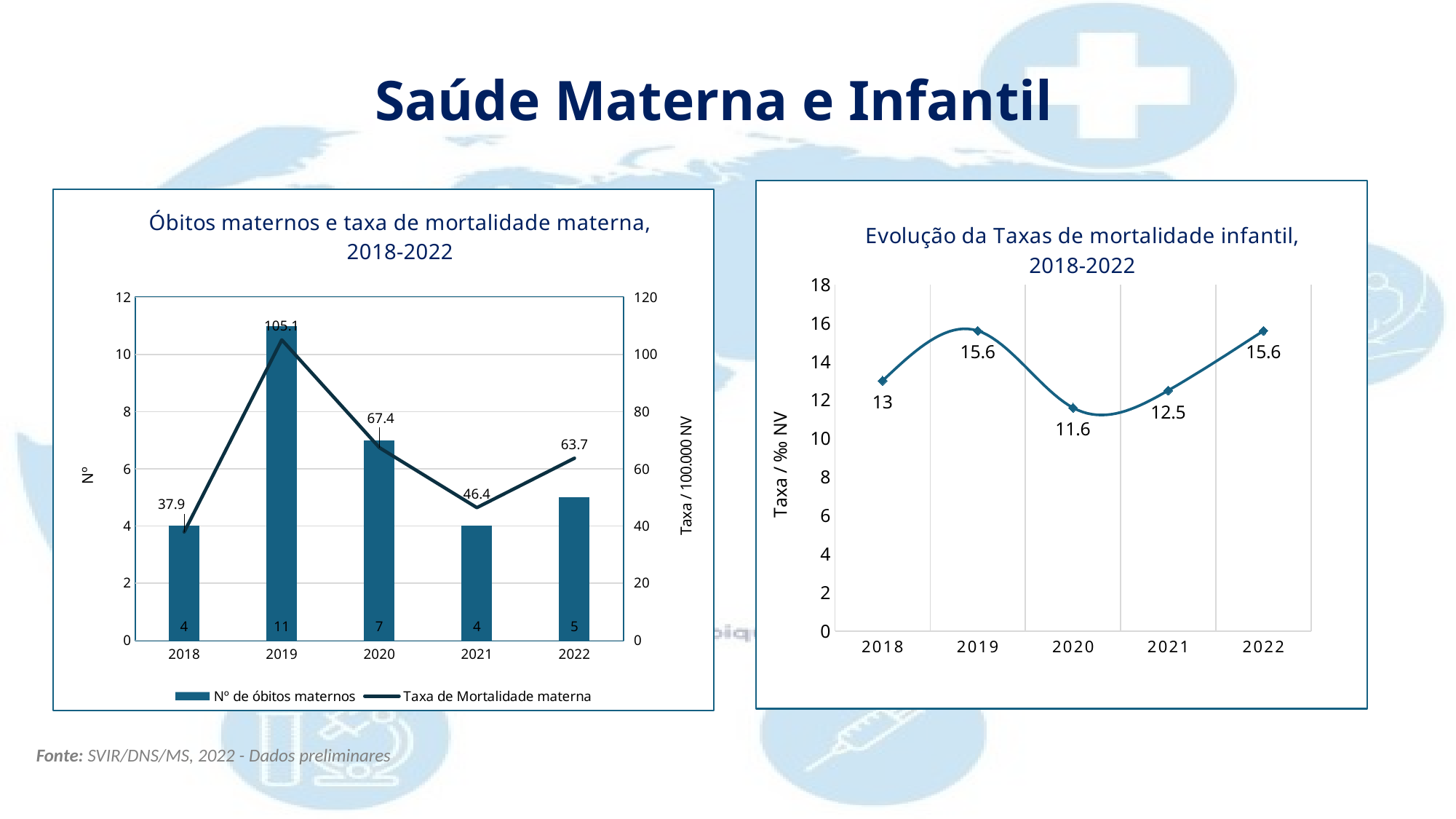
In the chart 'Evolução da Taxas de mortalidade infantil, 2018-2022', how many years are plotted? 5 In the chart 'Óbitos maternos e taxa de mortalidade materna, 2018-2022', is the Taxa de Mortalidade materna higher in 2021 or in 2022? 2022 In the chart 'Evolução da Taxas de mortalidade infantil, 2018-2022', which year has the lowest infant mortality rate? 2020 What type of chart is 'Evolução da Taxas de mortalidade infantil, 2018-2022'? Line chart In the chart 'Evolução da Taxas de mortalidade infantil, 2018-2022', what is the difference between the values for 2019 and 2018? 2.6 In the chart 'Óbitos maternos e taxa de mortalidade materna, 2018-2022', what is the number of maternal deaths (Nº de óbitos maternos) in 2019? 11 In the chart 'Óbitos maternos e taxa de mortalidade materna, 2018-2022', what is the difference between the number of maternal deaths in 2019 and in 2020? 4 In the chart 'Óbitos maternos e taxa de mortalidade materna, 2018-2022', which year has the lowest Taxa de Mortalidade materna? 2018 In the chart 'Evolução da Taxas de mortalidade infantil, 2018-2022', what is the value for 2020? 11.6 In the chart 'Óbitos maternos e taxa de mortalidade materna, 2018-2022', which year has the highest Taxa de Mortalidade materna? 2019 In the chart 'Óbitos maternos e taxa de mortalidade materna, 2018-2022', what is the Taxa de Mortalidade materna for 2020? 67.4 In the chart 'Óbitos maternos e taxa de mortalidade materna, 2018-2022', how many series does the legend list? 2